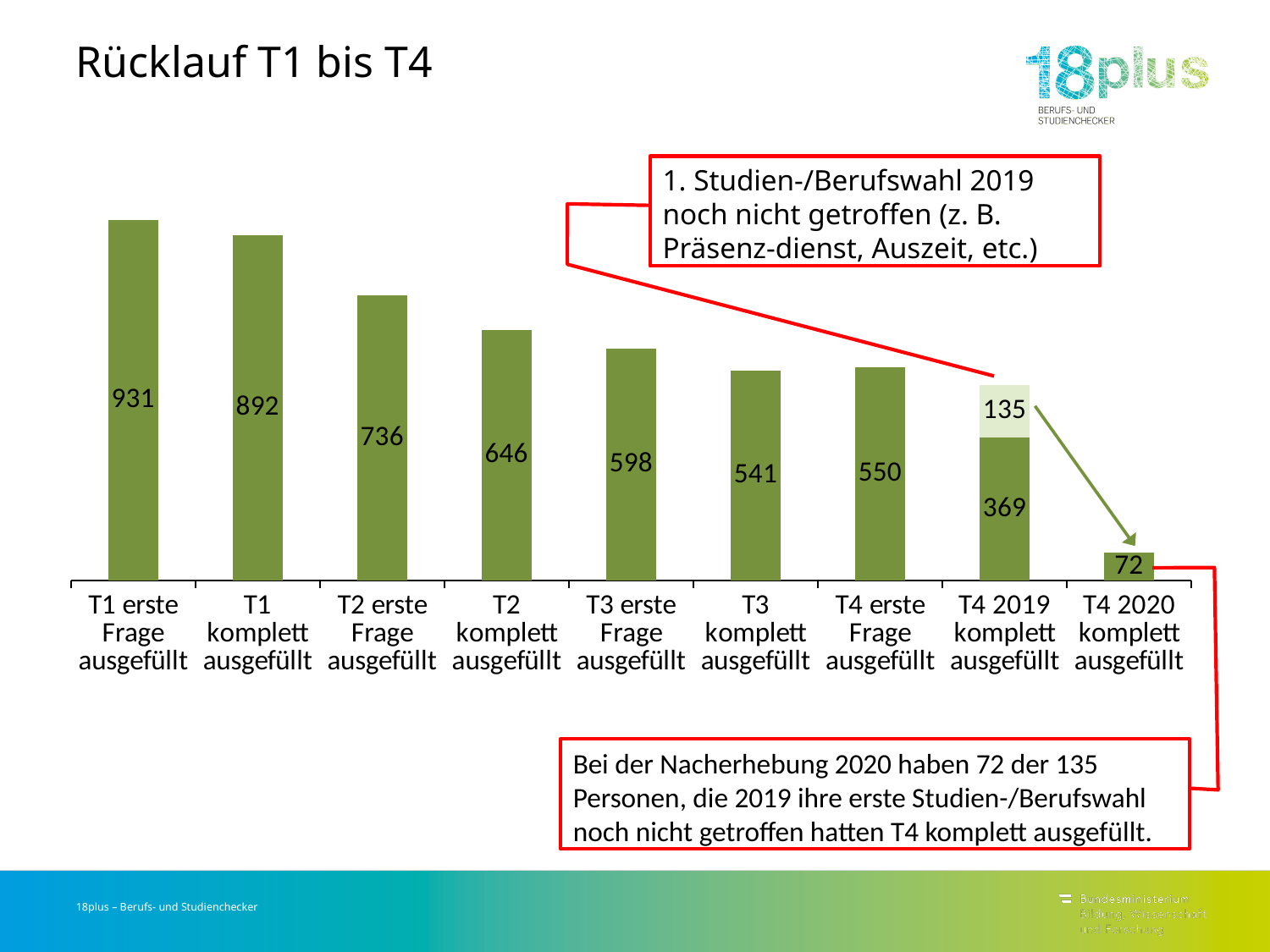
What kind of chart is shown on the slide? Bar chart What is the value of the lower (dark green) segment of the "T4 2019 komplett ausgefüllt" bar? 369 What is the difference between "T2 erste Frage ausgefüllt" and "T3 erste Frage ausgefüllt"? 138 What is the value for "T2 komplett ausgefüllt"? 646 What is the total of the stacked bar for "T4 2019 komplett ausgefüllt"? 504 What is the value for "T1 erste Frage ausgefüllt"? 931 Which is larger, "T3 komplett ausgefüllt" or "T4 erste Frage ausgefüllt"? T4 erste Frage ausgefüllt How many categories are shown on the x axis? 9 Which category has the lowest value? T4 2020 komplett ausgefüllt Which category has the highest value? T1 erste Frage ausgefüllt What is the value for "T4 2020 komplett ausgefüllt"? 72 What is the difference between "T1 erste Frage ausgefüllt" and "T1 komplett ausgefüllt"? 39